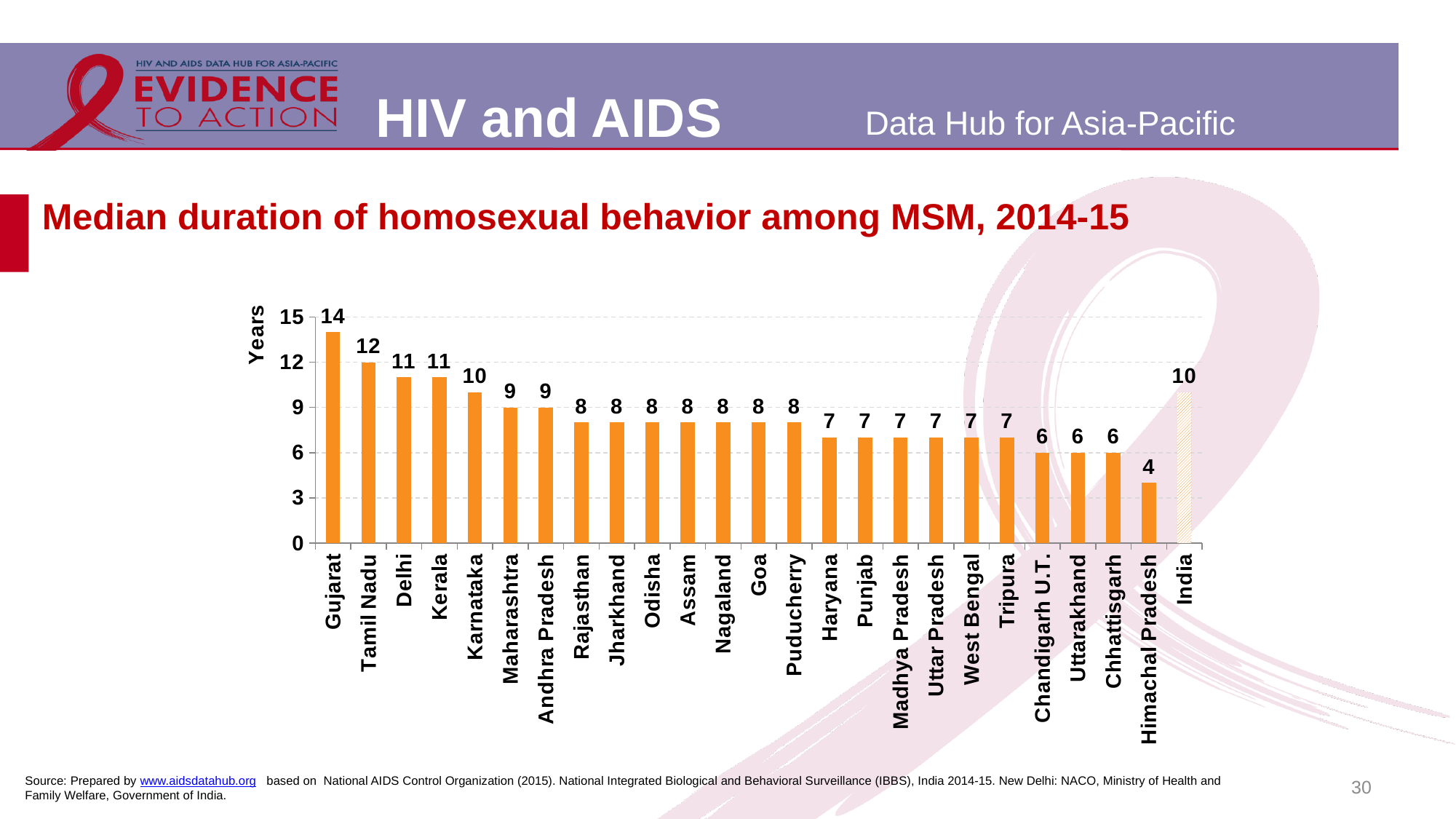
What type of chart is shown on the slide? Bar chart Which state has the lowest median duration in the chart? Himachal Pradesh What is the value shown for Himachal Pradesh? 4 What is the difference between the values for Kerala and Himachal Pradesh? 7 How many bars (categories) are plotted in the chart? 25 What is the label on the vertical axis of the chart? Years Which state has the highest median duration in the chart? Gujarat What value is shown for India in the chart? 10 What is the value shown for Karnataka? 10 What is the difference between the values for Gujarat and Tamil Nadu? 2 Which has a higher value, Tamil Nadu or Maharashtra? Tamil Nadu What is the median duration of homosexual behavior among MSM in Gujarat? 14